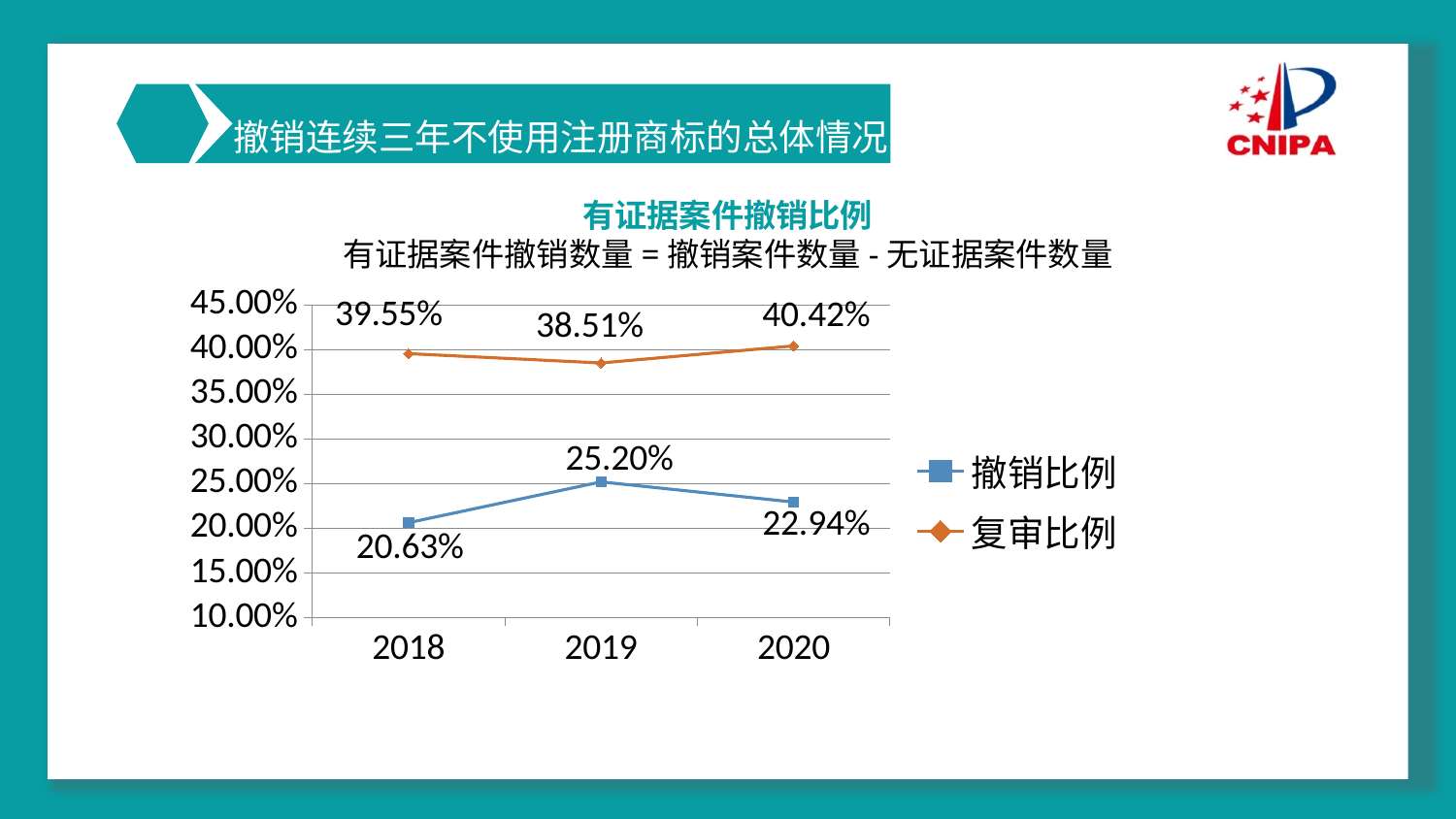
In which year is 复审比例 lowest? 2019 Which is larger in 2020, 撤销比例 or 复审比例? 复审比例 What is the value of 撤销比例 in 2019? 25.20% Is the value of 撤销比例 in 2020 greater or less than 20.00%? greater How many years are shown on the x axis? 3 In which year is 撤销比例 highest? 2019 What is the value of 撤销比例 in 2018? 20.63% What is the value of 复审比例 in 2020? 40.42% What kind of chart is shown on the slide? line chart What is the difference between 复审比例 and 撤销比例 in 2018? 18.92% Does 撤销比例 rise or fall from 2019 to 2020? fall How many series does the legend list? 2